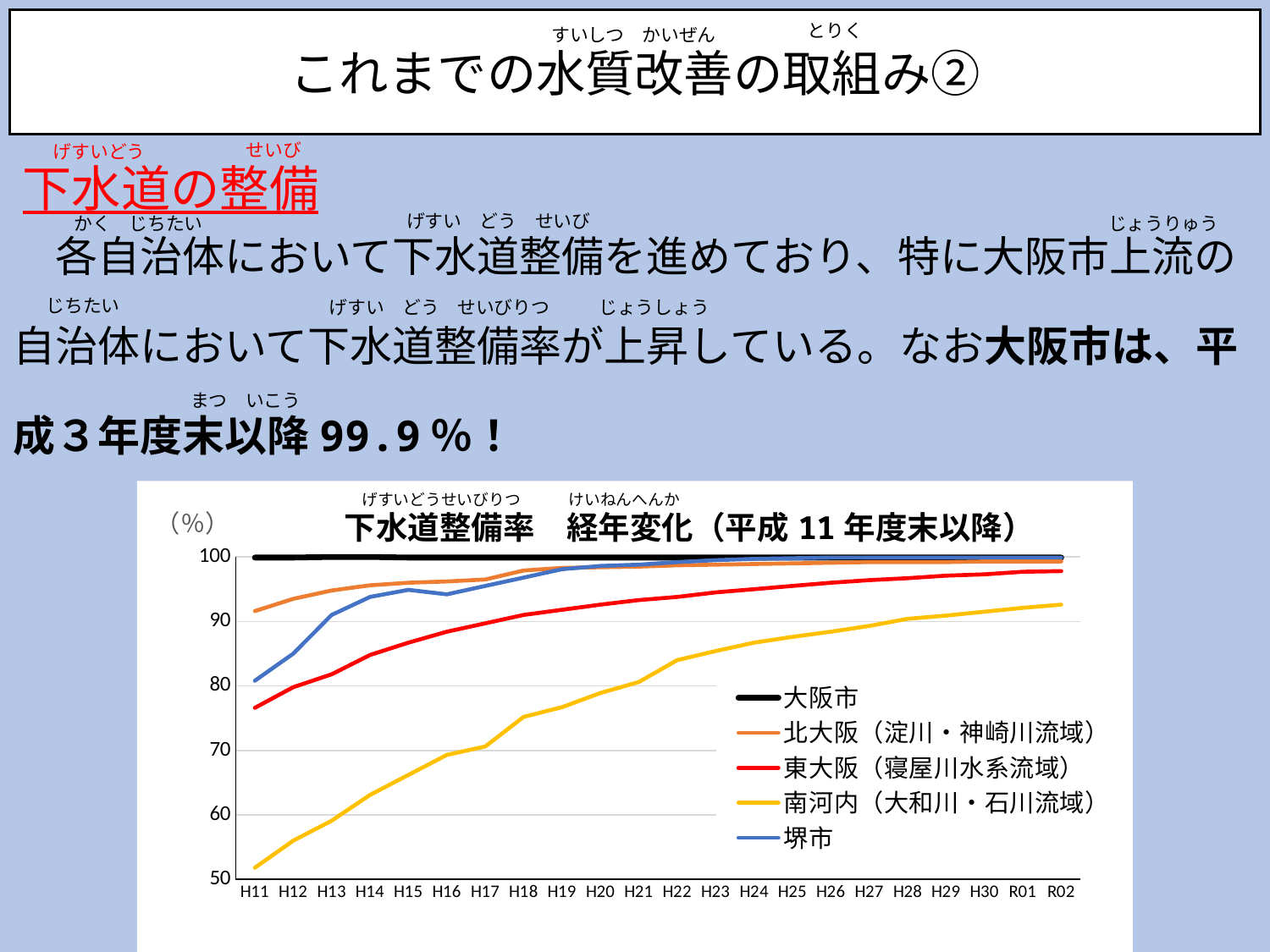
Is the value for 南河内（大和川・石川流域） at H11 greater or less than 60? less How many points are on the x axis of the chart (from H11 to R02)? 22 Which series has the lowest value at H11? 南河内（大和川・石川流域） Is the value for 東大阪（寝屋川水系流域） at H11 greater or less than 70? greater At H11, which is larger: the value for 北大阪（淀川・神崎川流域） or the value for 堺市? 北大阪（淀川・神崎川流域） What kind of chart is shown on the slide? line chart Which series is drawn with a black line in the chart? 大阪市 Which series has the highest value at H11? 大阪市 Is the value for 南河内（大和川・石川流域） at R02 greater or less than 90? greater Does the value for 南河内（大和川・石川流域） rise or fall from H11 to R02? rise How many series does the legend of the chart list? 5 What is the title of the chart? 下水道整備率 経年変化（平成11年度末以降）